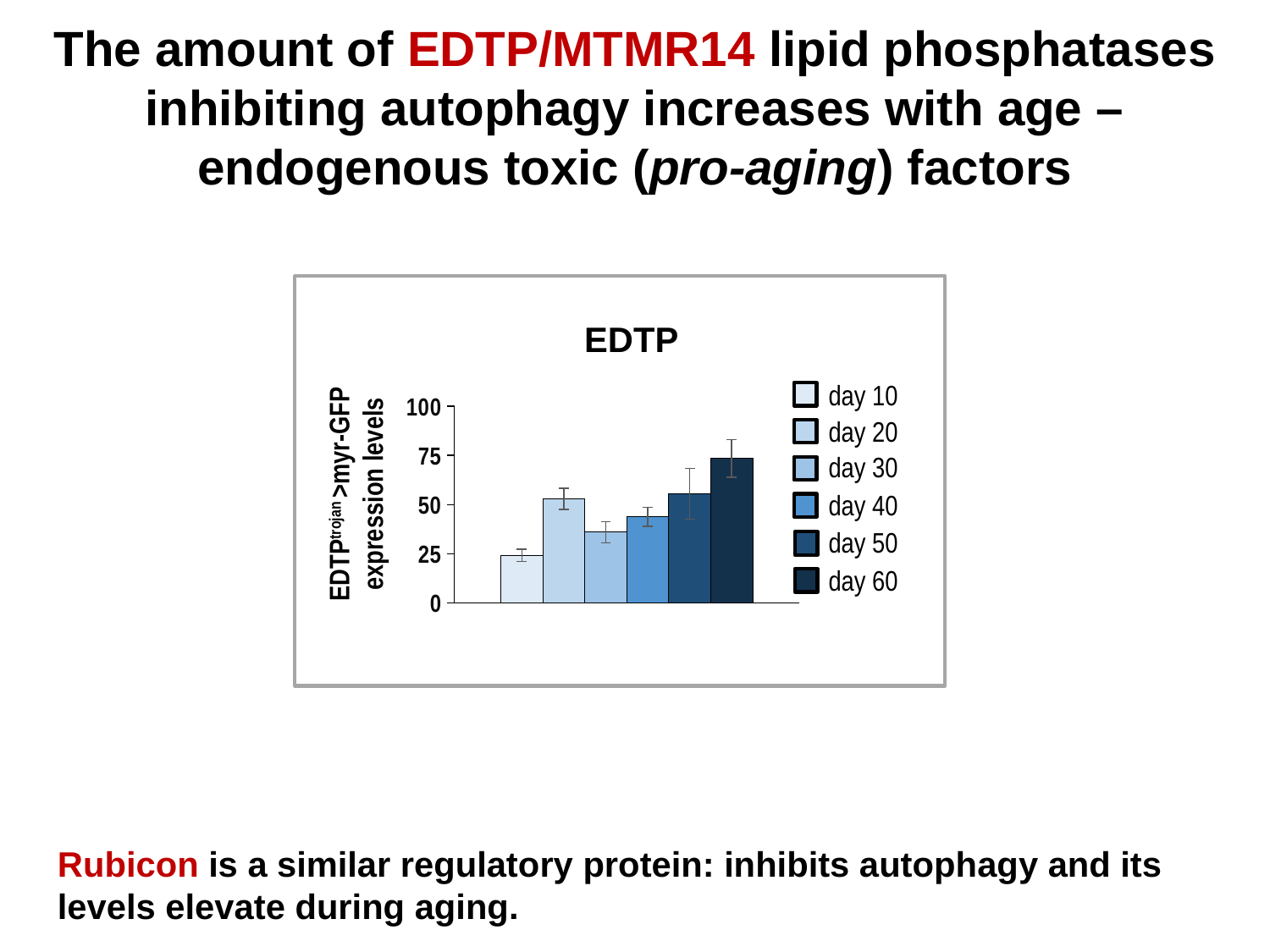
What is the highest tick value shown on the y axis? 100 Which has the larger value, day 20 or day 30? day 20 What kind of chart is shown on the slide? bar chart Which day has the lowest EDTP expression level? day 10 Is the value for day 60 greater or less than 50? greater Which has the larger value, day 50 or day 60? day 60 How many bars are plotted in the chart? 6 Is the value for day 10 greater or less than 50? less Which day has the highest EDTP expression level? day 60 What is the title of the chart? EDTP How many entries does the chart's legend list? 6 Is the value for day 30 greater or less than 50? less